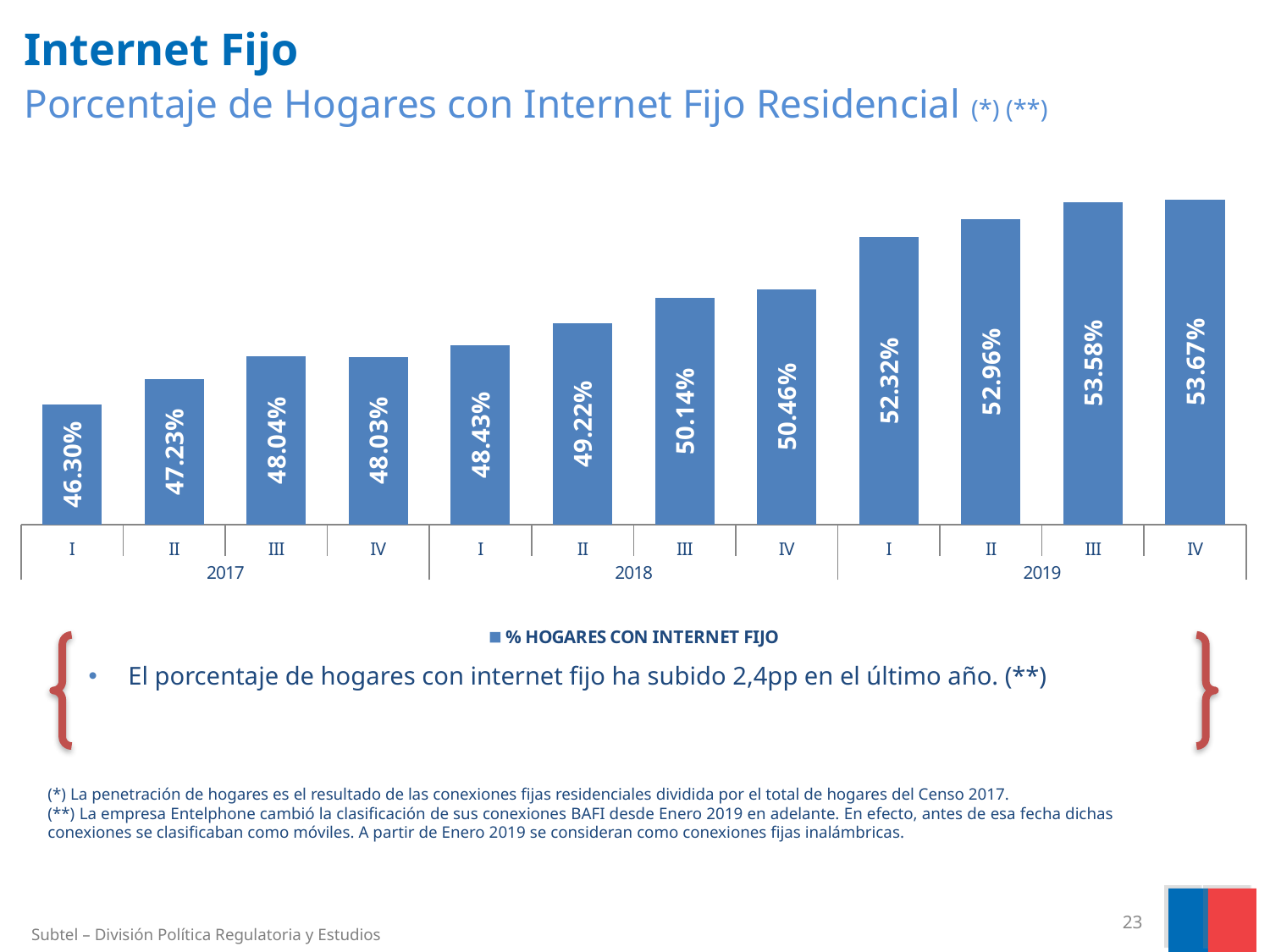
How many bars are plotted in the chart? 12 What is the difference between the values for quarter IV of 2019 and quarter IV of 2018? 3.21% Which quarter has the lowest value? I 2017 Which quarter has the highest value? IV 2019 What is the value for quarter I of 2017? 46.30% How many series does the legend list? 1 What is the value for quarter III of 2018? 50.14% What is the value for quarter IV of 2019? 53.67% Which is larger, the value for quarter II of 2018 or the value for quarter II of 2019? II 2019 Do the values generally rise or fall from 2017 to 2019? Rise What kind of chart is shown on the slide? Bar chart What is the difference between the values for quarter I of 2019 and quarter I of 2018? 3.89%